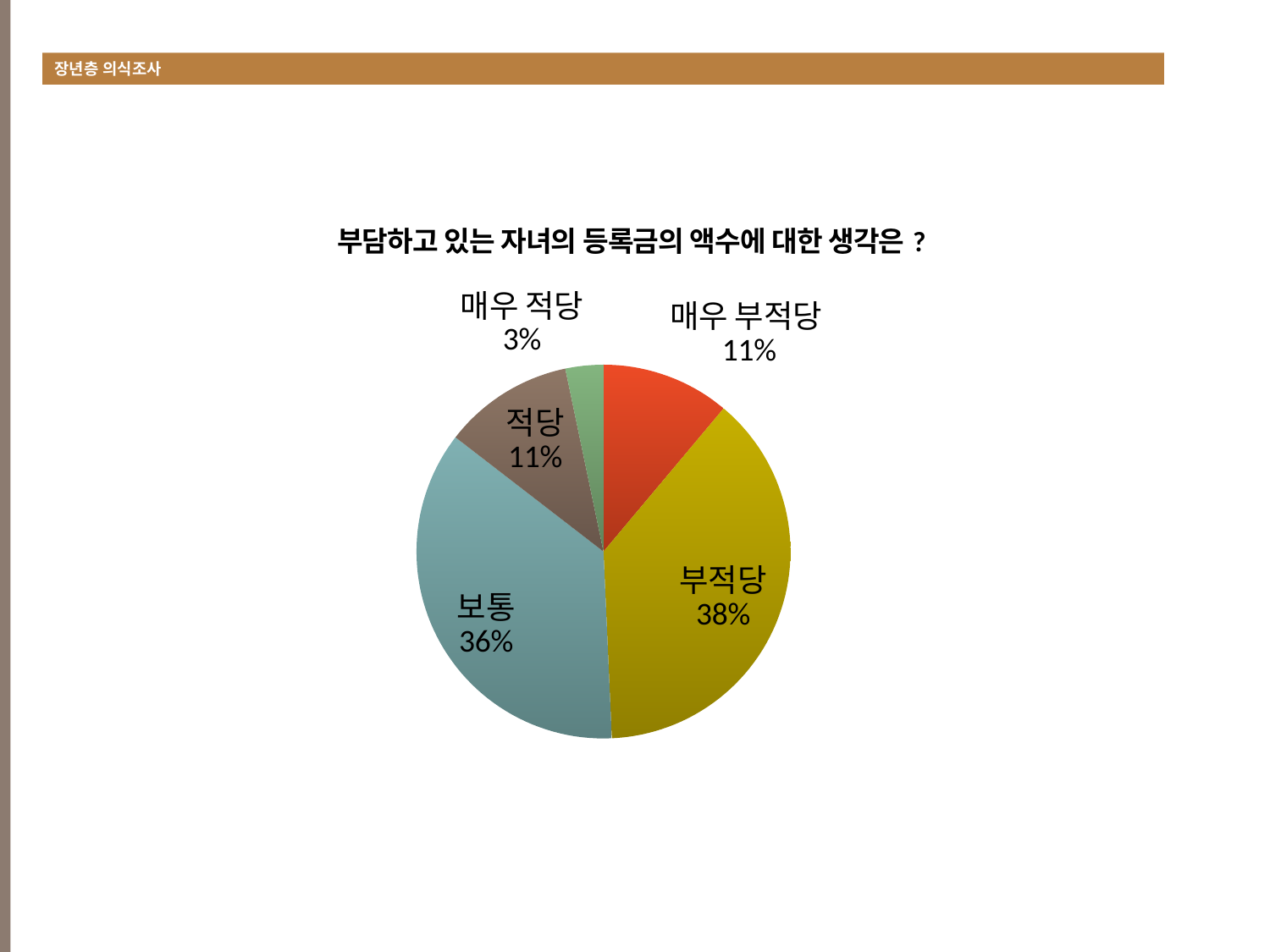
What kind of chart is shown on the slide? Pie chart Which is larger, the 적당 slice or the 매우 적당 slice? 적당 What is the value shown for 매우 적당? 3% How many categories are shown in the pie chart? 5 What percentage of the pie chart is labelled 부적당? 38% What is the combined percentage of 부적당 and 매우 부적당? 49% Which category has the largest slice of the pie? 부적당 What is the value shown for 매우 부적당? 11% What share does the 보통 slice have in the pie chart? 36% What is the difference in percentage points between 부적당 and 보통? 2 Which category has the smallest slice of the pie? 매우 적당 What is the title of the chart? 부담하고 있는 자녀의 등록금의 액수에 대한 생각은 ?